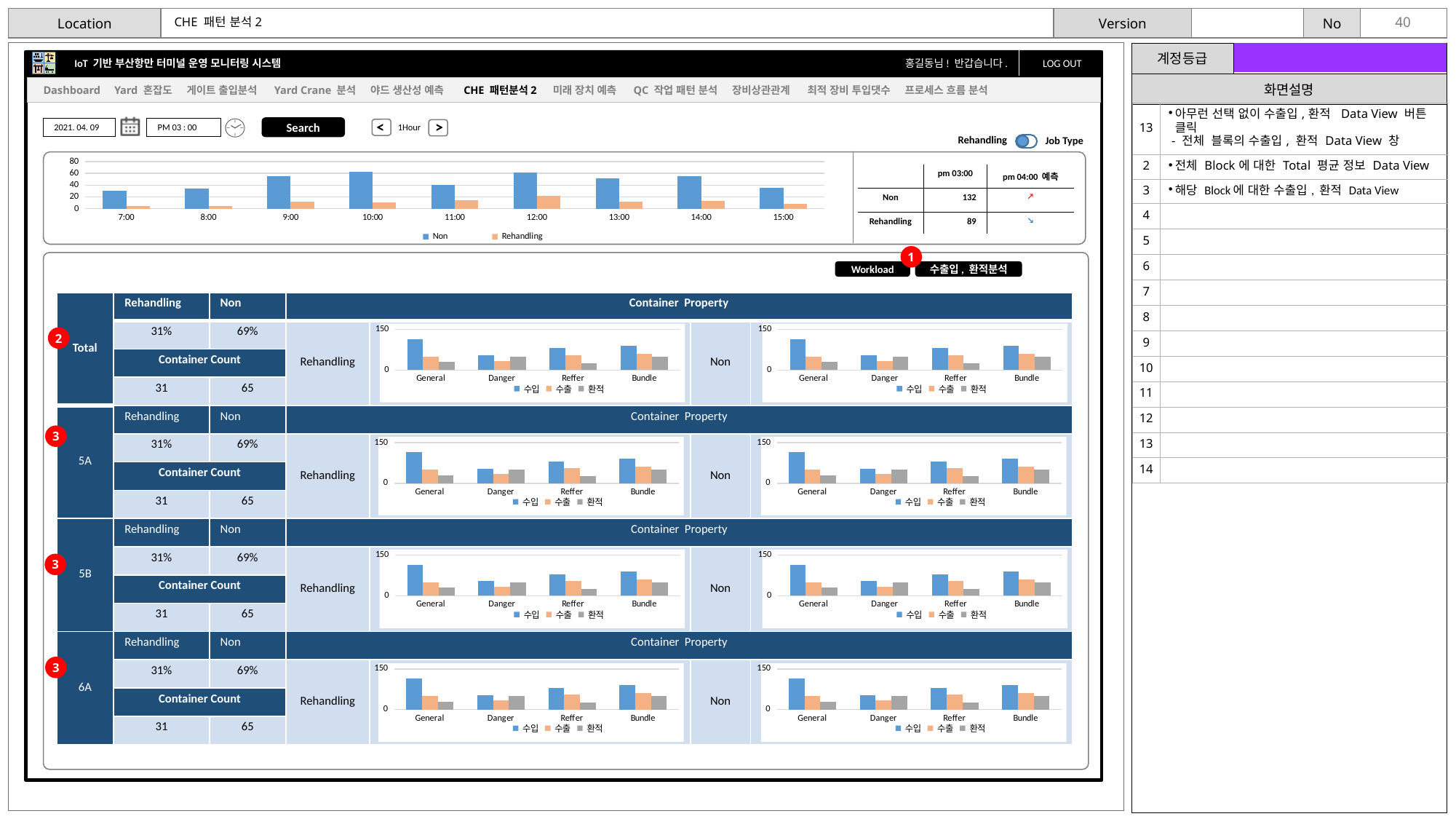
In the top hourly chart, at which time is the Rehandling value highest? 12:00 In the top hourly chart, is the Non value at 7:00 greater or less than 40? less In the top hourly chart, is the Non value at 10:00 greater or less than 40? greater In the top hourly chart, which is larger for Non, 10:00 or 8:00? 10:00 In the top hourly chart, how many series does the legend list? 2 In the Total row's Rehandling Container Property chart, how many categories are on the x axis? 4 In the top hourly chart, what are the two legend entries? Non, Rehandling In the Total row's Rehandling Container Property chart, which category has the highest 수입 value? General In the top hourly chart, which is larger at 12:00, Non or Rehandling? Non In the Total row's Rehandling Container Property chart, how many series does the legend list? 3 In the top hourly chart, what kind of chart is it? bar chart In the top hourly chart, how many time categories are shown on the x axis? 9